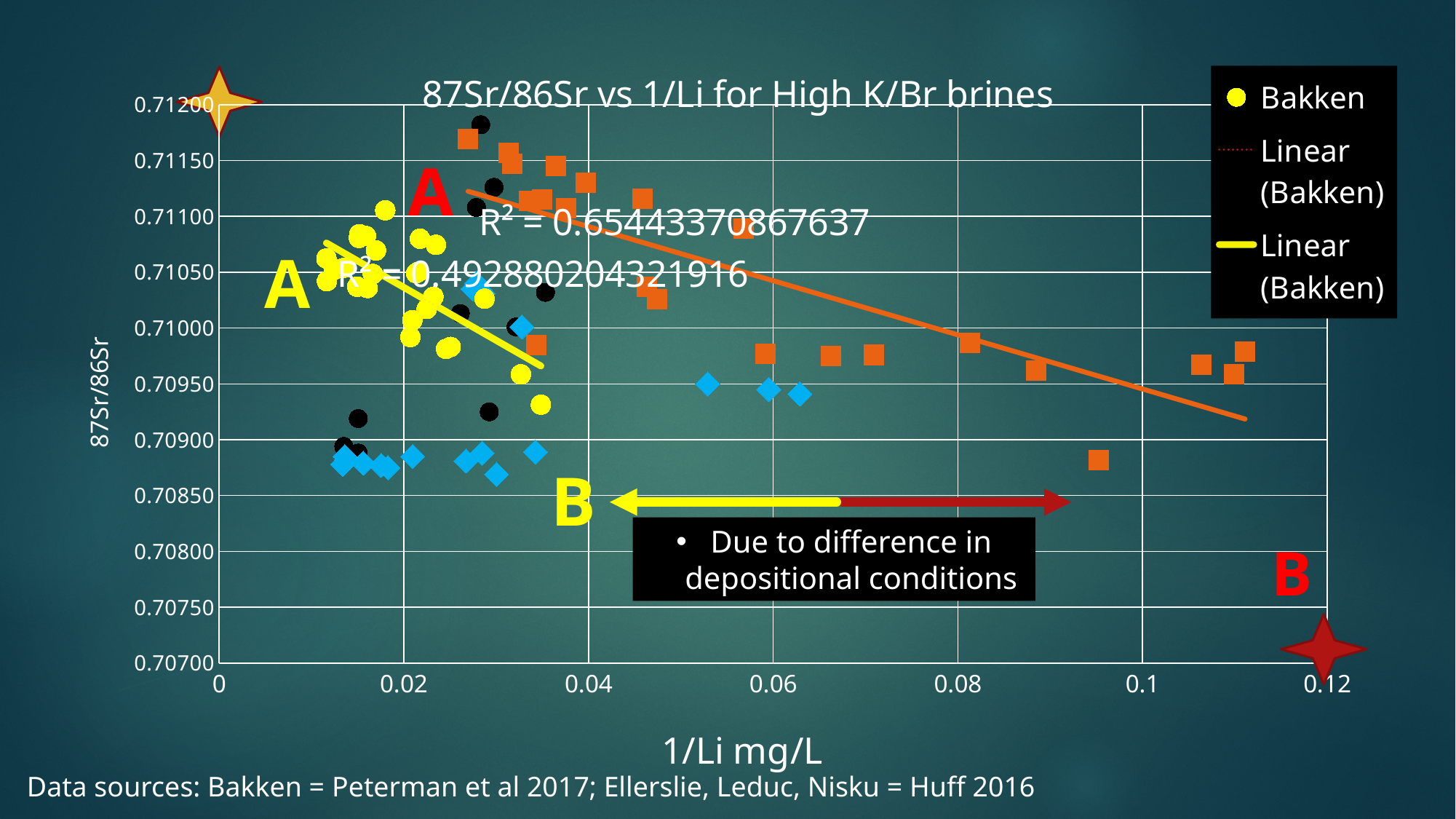
Is the 87Sr/86Sr value of the highest orange square, plotted near 1/Li = 0.027, greater or less than 0.71150? greater What R² value is printed for the orange trend line (the upper R² label)? 0.65443370867637 What kind of chart is shown on the slide? Scatter chart What is the label of the x axis? 1/Li mg/L How many entries does the chart legend list? 3 What is the lowest value shown on the y axis? 0.70700 Do the fitted trend lines rise or fall as 1/Li increases along the x axis? Fall What R² value is printed for the yellow trend line (the lower R² label)? 0.492880204321916 Is the 87Sr/86Sr value of the orange square plotted near 1/Li = 0.111 (the upper one) greater or less than 0.70950? greater Is the 87Sr/86Sr value of the orange square plotted near 1/Li = 0.096 greater or less than 0.70900? less What is the title of the chart? 87Sr/86Sr vs 1/Li for High K/Br brines What is the highest value shown on the x axis? 0.12